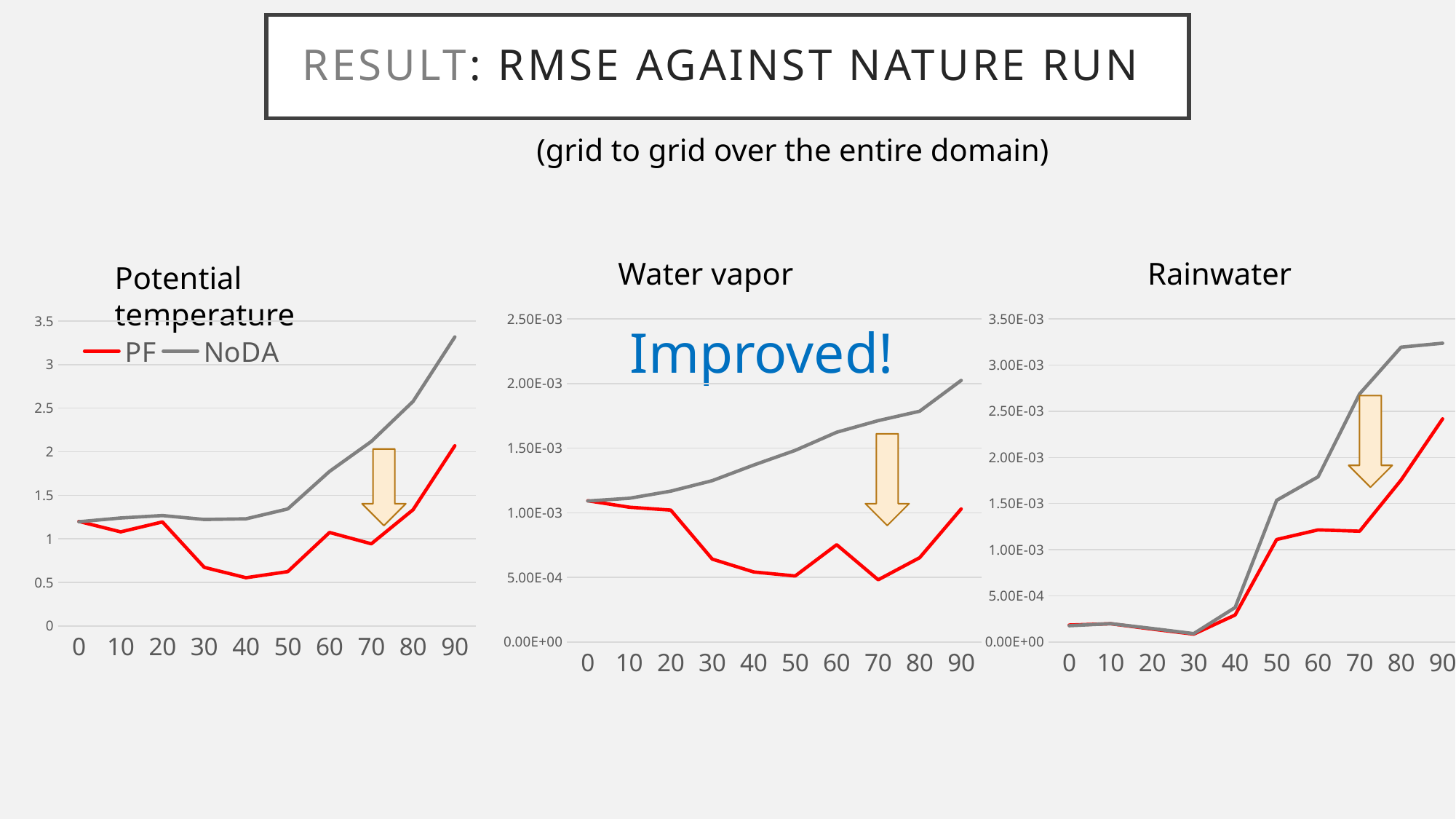
In the Water vapor chart, which series has the larger value at 60, PF or NoDA? NoDA How many series does the legend on the Potential temperature chart list? 2 In the Water vapor chart, is the PF value at 30 greater or less than 1.00E-03? less In the Rainwater chart, does the NoDA series generally rise or fall from 30 to 90 along the x axis? rise What colour is the PF series line in the charts? red In the Potential temperature chart, is the NoDA value at 90 greater or less than 3? greater In the Rainwater chart, is the NoDA value at 80 greater or less than 3.00E-03? greater What kind of chart is the Potential temperature chart? line chart In the Potential temperature chart, which series has the larger value at 90, PF or NoDA? NoDA In the Water vapor chart, how many x-axis points are plotted for each series? 10